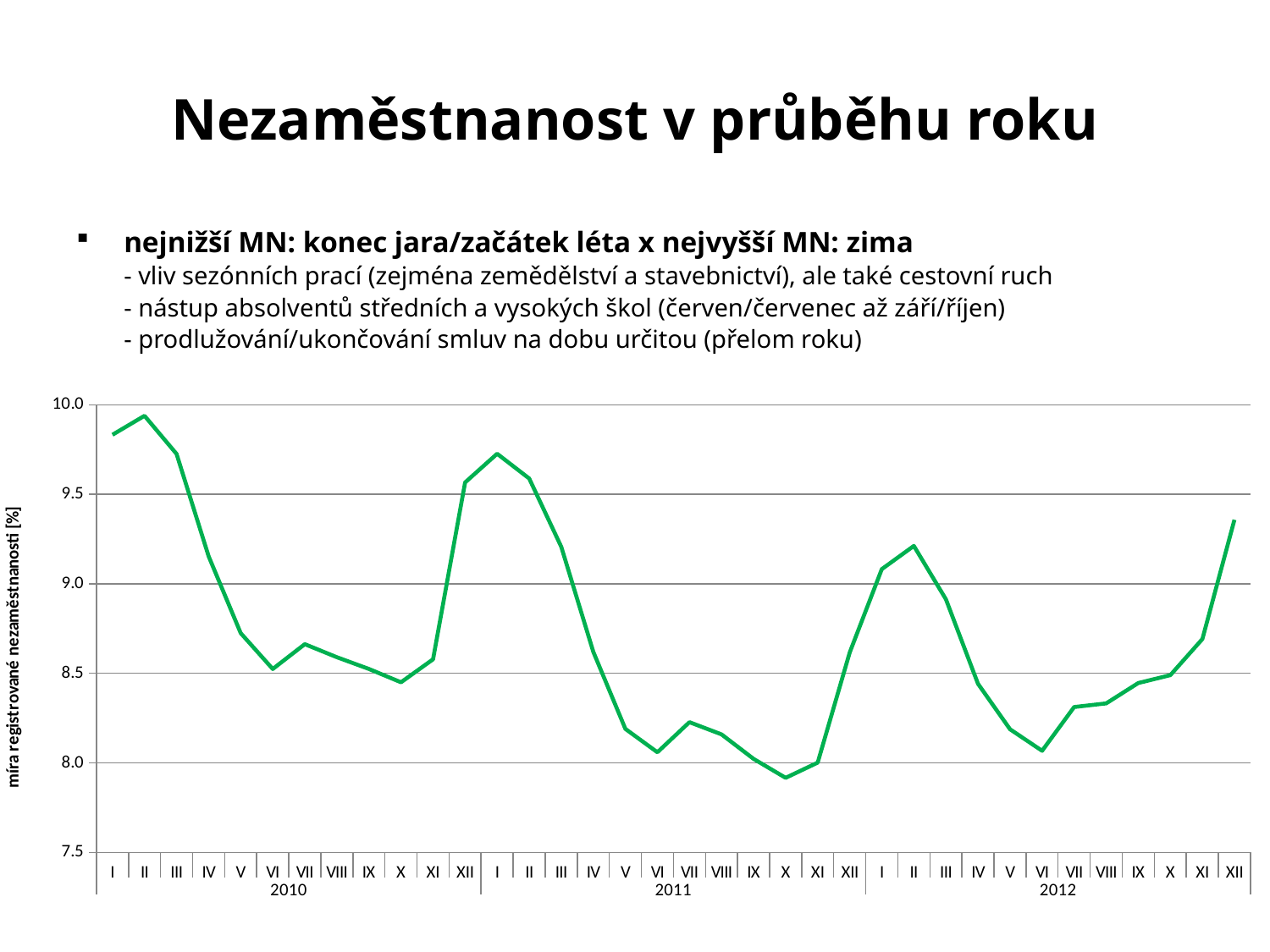
What kind of chart is shown on the slide? line chart What is the label of the vertical axis? míra registrované nezaměstnanosti [%] In which month and year does the line reach its lowest value? X 2011 Is the value for I 2011 greater or less than 9.5? greater In which month and year does the line reach its highest value? II 2010 Which is larger, the value for II 2011 or the value for II 2012? II 2011 Is the value for I 2010 greater or less than 9.5? greater Is the value for X 2011 greater or less than 8.0? less Does the line rise or fall from II 2010 to VI 2010? fall How many monthly data points are plotted on the chart? 36 How many years are shown on the x axis of the chart? 3